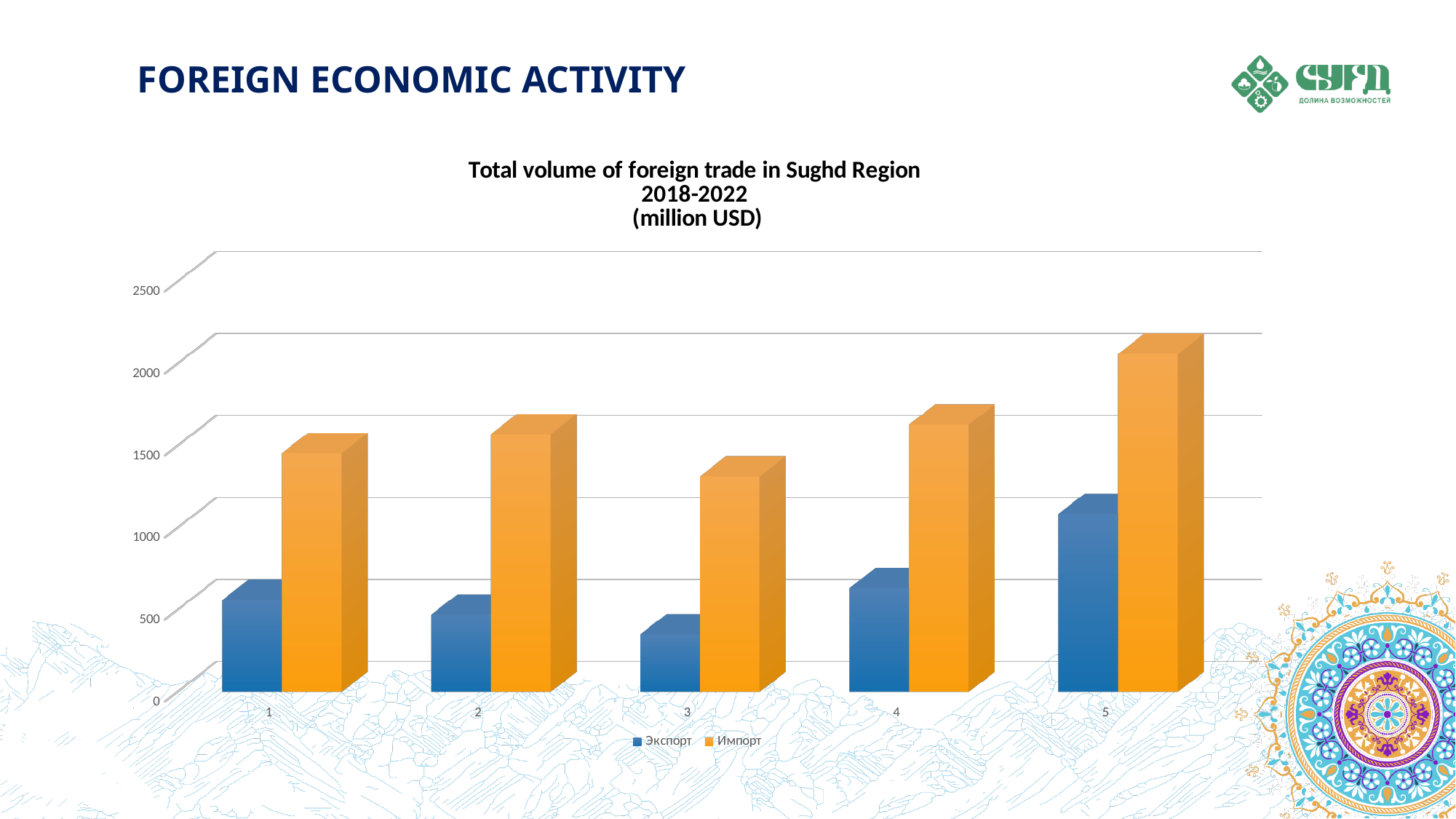
Which category has the highest Экспорт value? 5 Is the Экспорт value for category 3 greater or less than 500? less Which category has the lowest Импорт value? 3 Which is larger, the Экспорт value for category 4 or for category 2? category 4 How many categories are shown on the x axis? 5 How many series does the legend list? 2 What are the two series named in the legend? Экспорт and Импорт Which category has the highest Импорт value? 5 What kind of chart is shown on the slide? bar chart Is the Экспорт value for category 5 greater or less than 1000? greater Which category has the lowest Экспорт value? 3